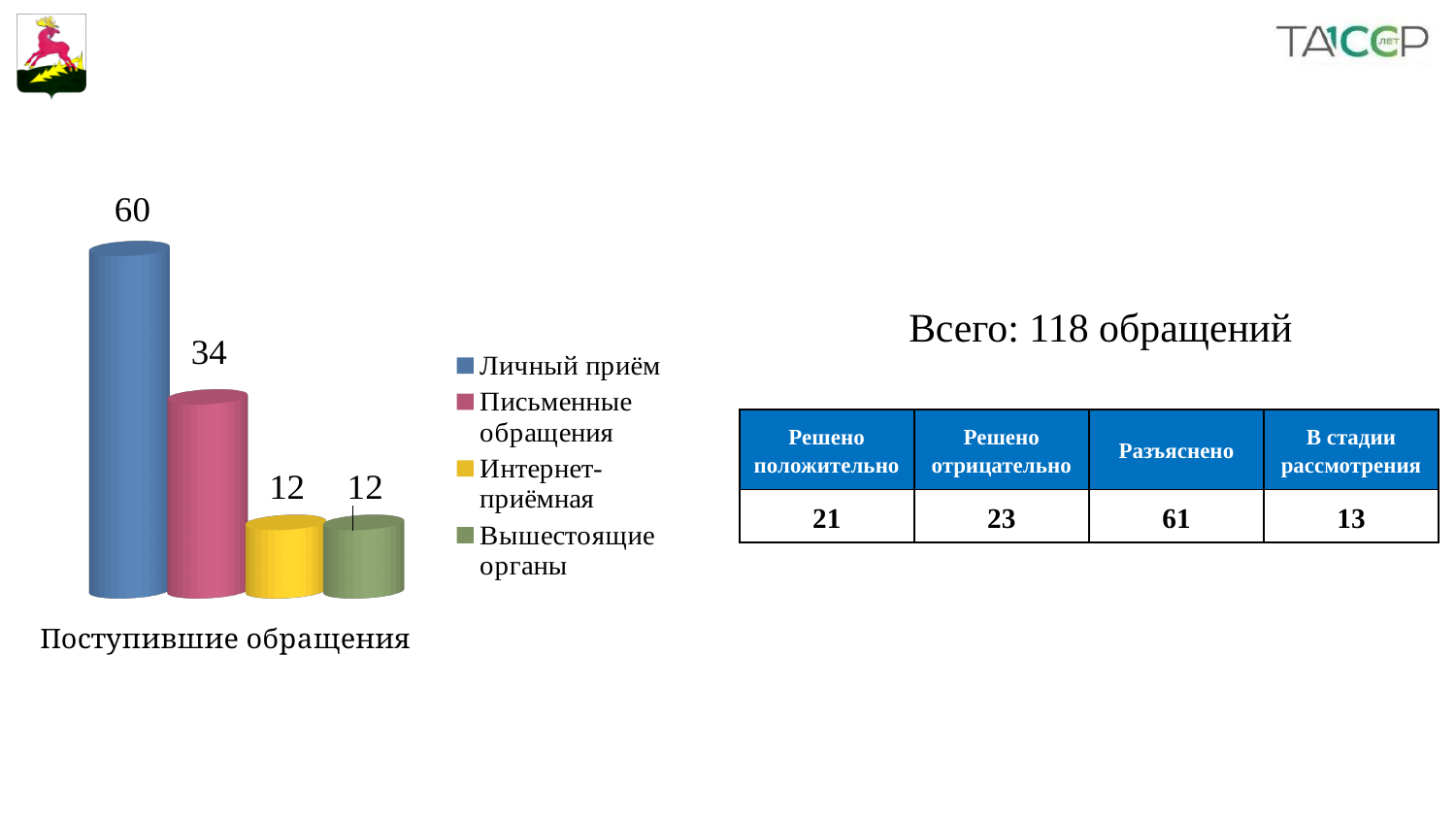
What is the value for Личный приём in the chart? 60 Which is larger, the value for Личный приём or the value for Письменные обращения? Личный приём What is the difference between the values for Личный приём and Письменные обращения? 26 How many bars are plotted in the chart? 4 What is the value for Письменные обращения in the chart? 34 Which series has the highest value in the chart? Личный приём What is the difference between the values for Письменные обращения and Вышестоящие органы? 22 What is the category label shown below the bars of the chart? Поступившие обращения What colour is the bar for Интернет-приёмная in the chart? yellow How many series does the chart legend list? 4 What is the value for Интернет-приёмная in the chart? 12 What kind of chart is shown on the slide? bar chart